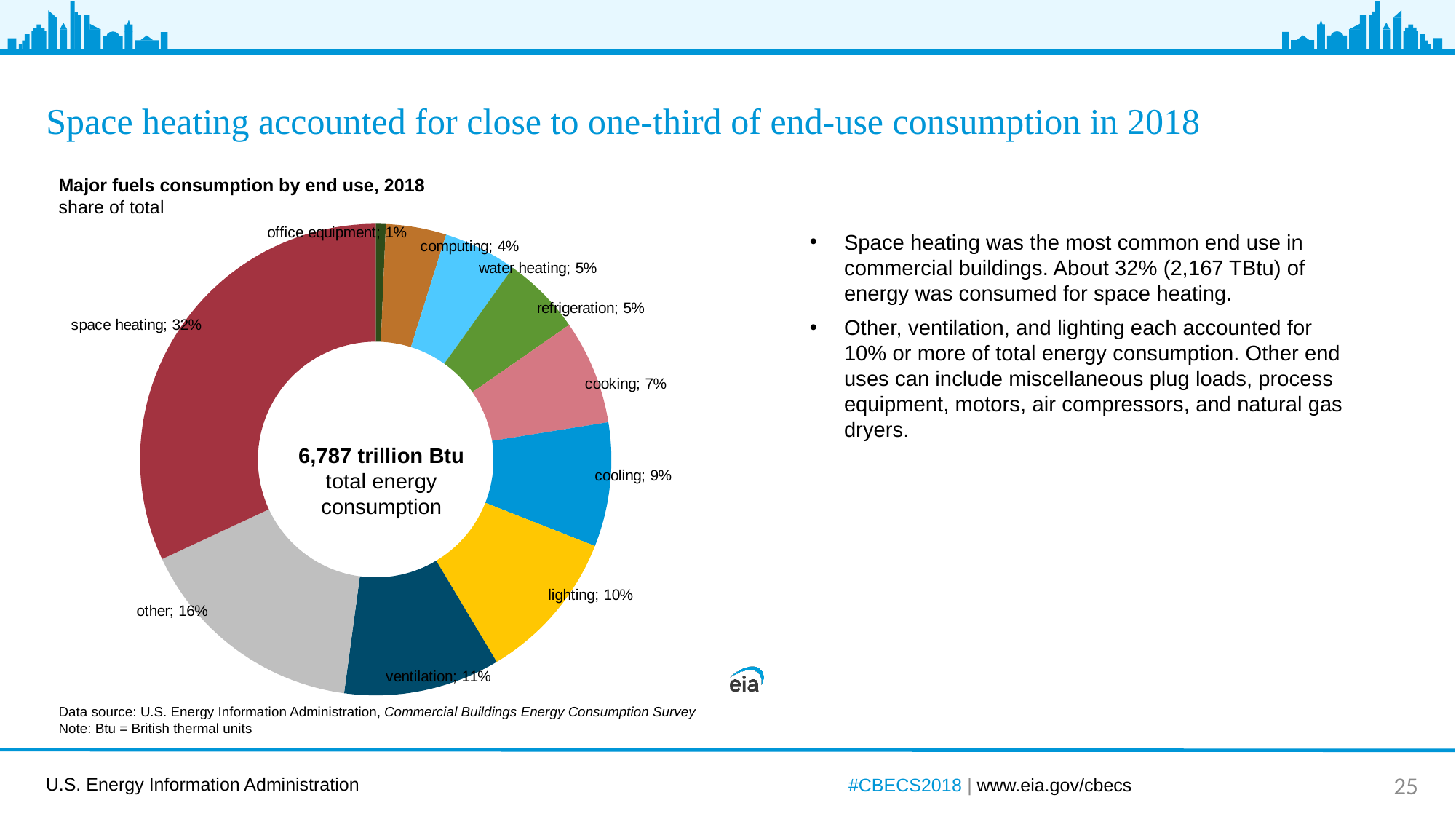
Which end use has the largest share of consumption? space heating What is the combined share of water heating and refrigeration? 10% What share of total major fuels consumption does space heating account for? 32% How many percentage points larger is the share for space heating than the share for other? 16 What kind of chart is shown on the slide? doughnut chart What share of total consumption does cooking account for? 7% How many end-use categories are shown in the chart? 10 What share of total consumption is attributed to ventilation? 11% Which has a larger share, lighting or cooling? lighting What total energy consumption value is shown in the center of the chart? 6,787 trillion Btu Which end use has the smallest share of consumption? office equipment What is the title of the chart? Major fuels consumption by end use, 2018